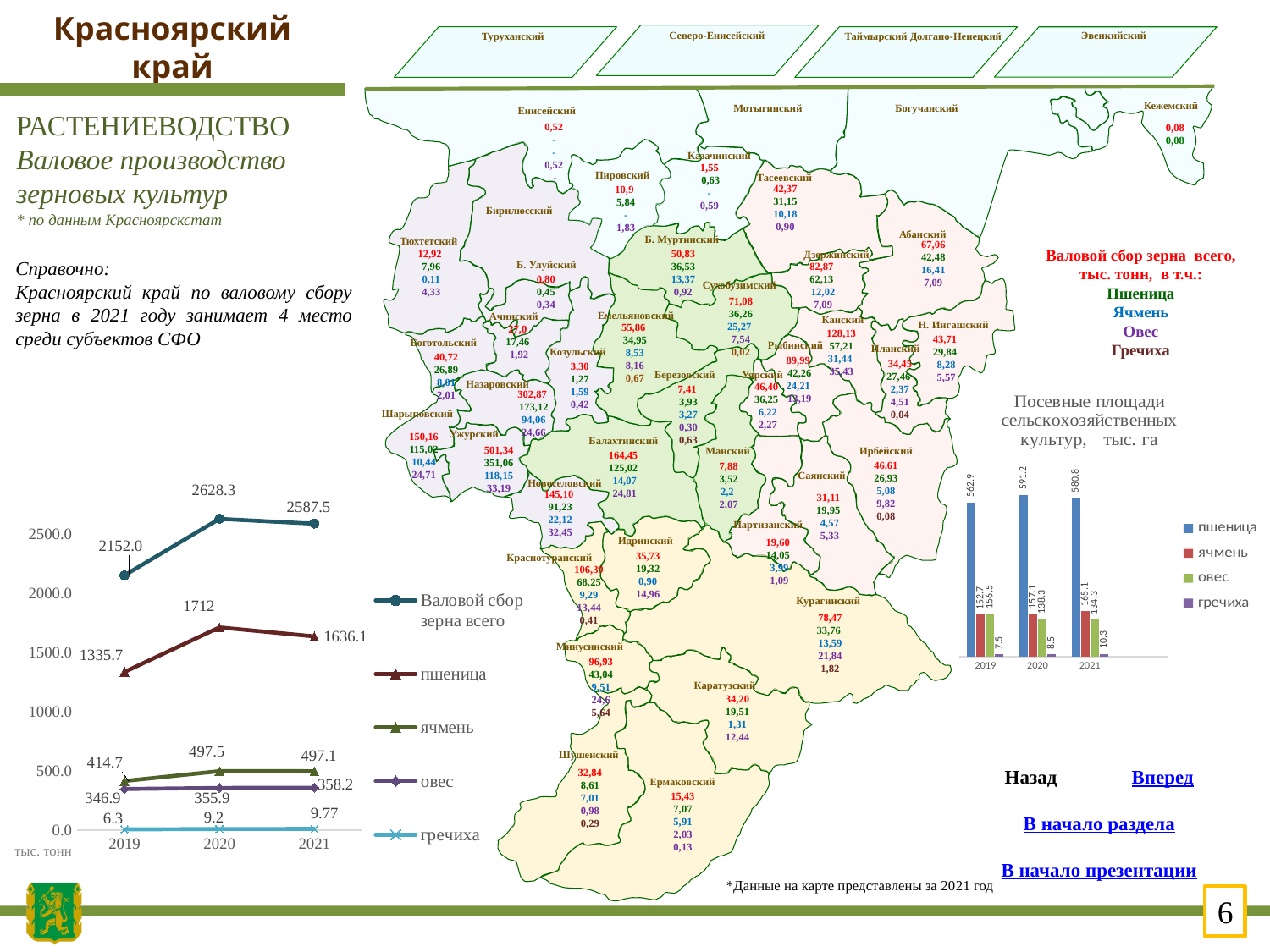
What kind of chart is the chart titled 'Посевные площади сельскохозяйственных культур'? bar chart On the bar chart titled 'Посевные площади сельскохозяйственных культур', what is the value for 'пшеница' in 2020? 591.2 On the bar chart titled 'Посевные площади сельскохозяйственных культур', what is the value for 'гречиха' in 2021? 10.3 On the line chart at the bottom left of the slide, what is the value of 'Валовой сбор зерна всего' for 2020? 2628.3 On the line chart at the bottom left of the slide, what is the value for 'пшеница' in 2021? 1636.1 On the line chart at the bottom left of the slide, which is larger in 2021: 'ячмень' or 'овес'? ячмень On the line chart at the bottom left of the slide, in which year is 'Валовой сбор зерна всего' highest? 2020 On the line chart at the bottom left of the slide, does the 'овес' series rise or fall from 2019 to 2021? rise On the line chart at the bottom left of the slide, how many series does the legend list? 5 On the line chart at the bottom left of the slide, what is the difference between the 'пшеница' values for 2020 and 2019? 376.3 On the bar chart titled 'Посевные площади сельскохозяйственных культур', how many years are shown on the x axis? 3 On the bar chart titled 'Посевные площади сельскохозяйственных культур', in which year is the 'овес' value lowest? 2021